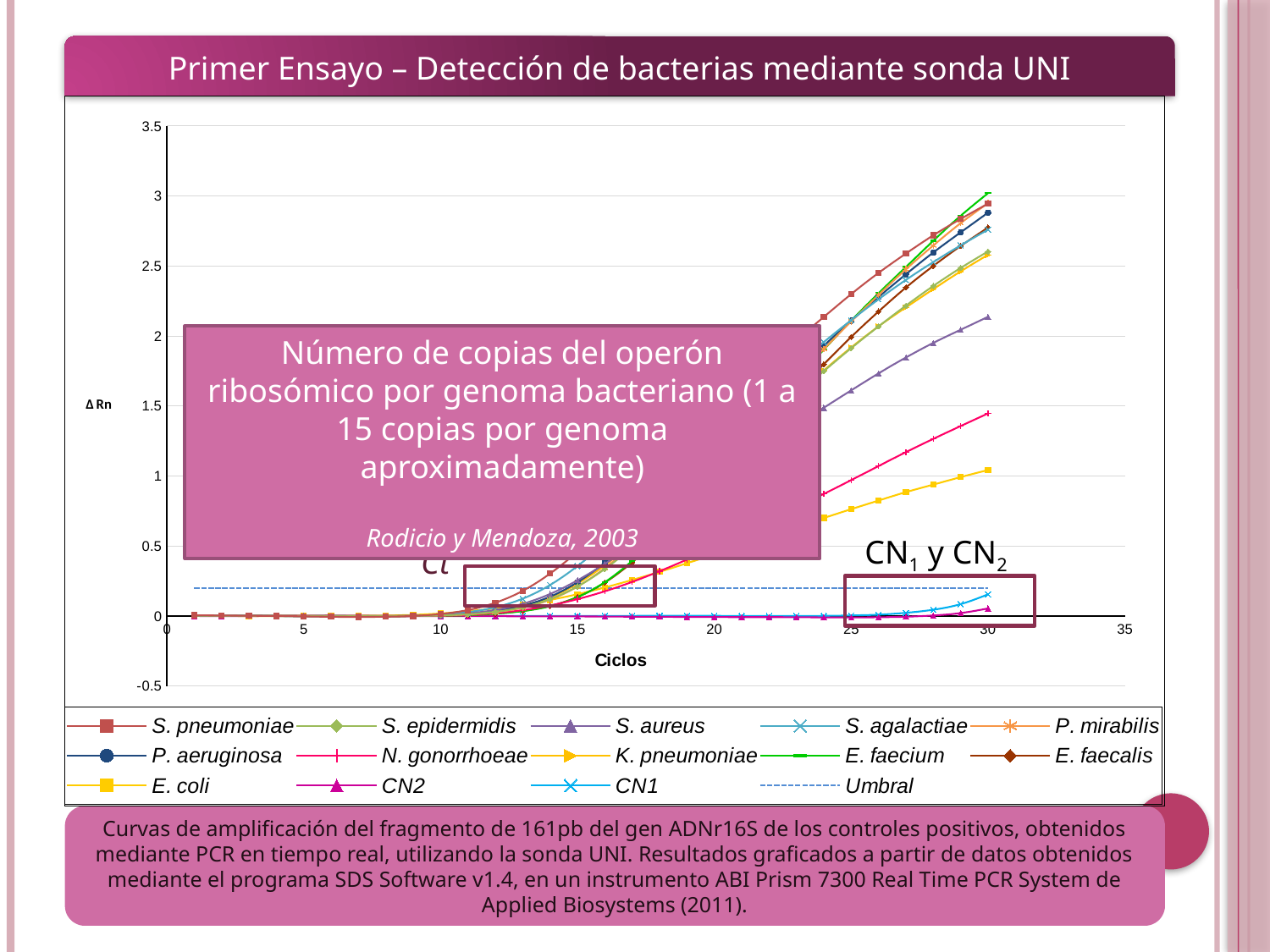
At cycle 30, which has the larger value, S. aureus or E. coli? S. aureus Is the value for E. coli at cycle 30 greater or less than 0.5? greater At cycle 30, which has the larger value, N. gonorrhoeae or E. coli? N. gonorrhoeae Is the value for CN2 at cycle 30 greater or less than 0.5? less Do the amplification curves rise or fall as the number of cycles increases? rise What is the label of the y axis of the chart? Δ Rn How many series does the chart legend list? 14 What kind of chart is shown on the slide? line chart Is the value for S. aureus at cycle 30 greater or less than 2.5? less What is the label of the x axis of the chart? Ciclos